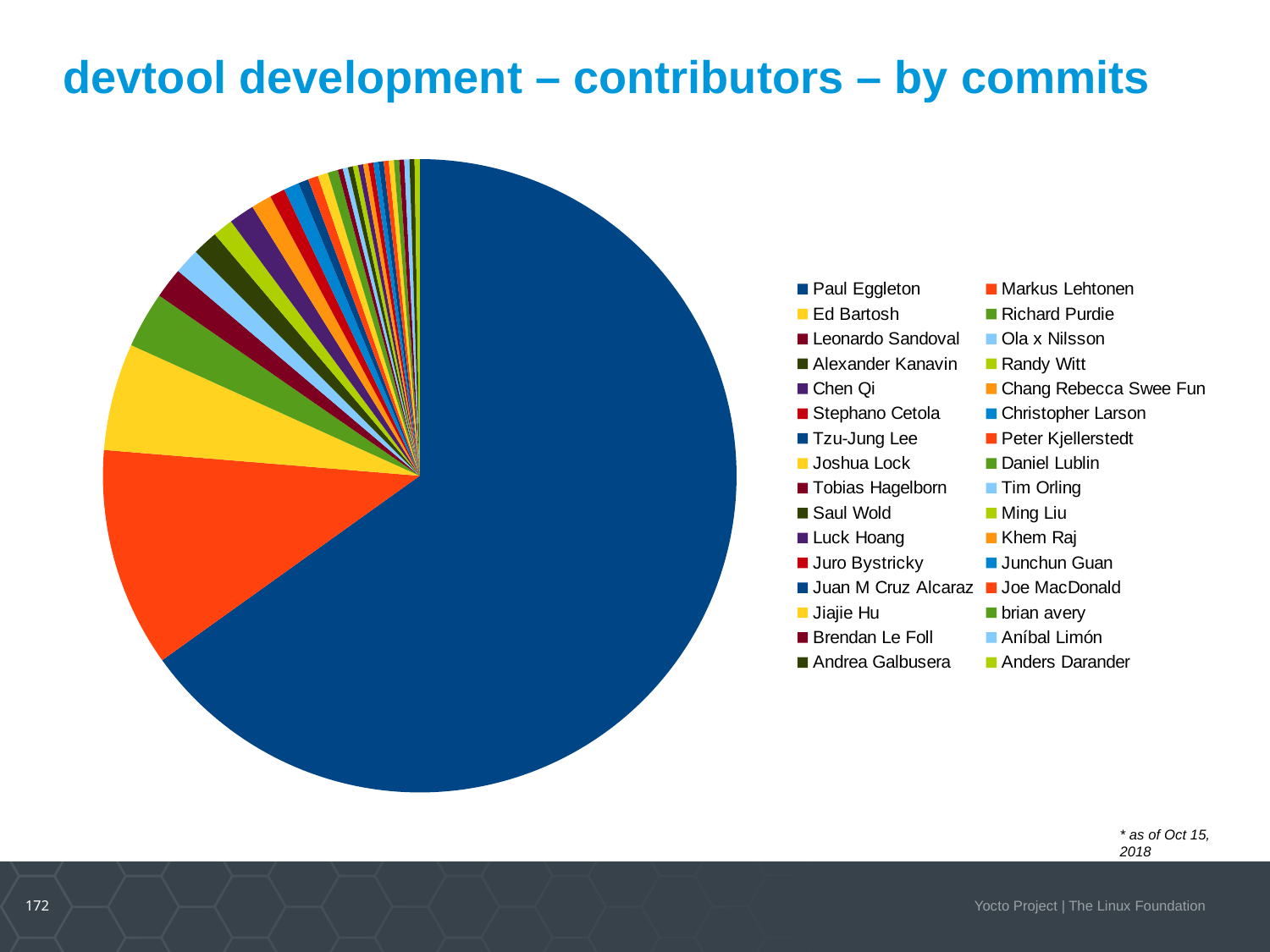
Does Paul Eggleton's slice account for more or less than half of the pie? more What colour is the largest slice of the pie? dark blue Which contributor has the largest slice of the pie? Paul Eggleton Which slice is larger, Markus Lehtonen's or Ed Bartosh's? Markus Lehtonen Which contributor has the second-largest slice of the pie? Markus Lehtonen How many contributors are listed in the legend? 32 What kind of chart is shown on the slide? pie chart What is the title of the slide containing the chart? devtool development – contributors – by commits